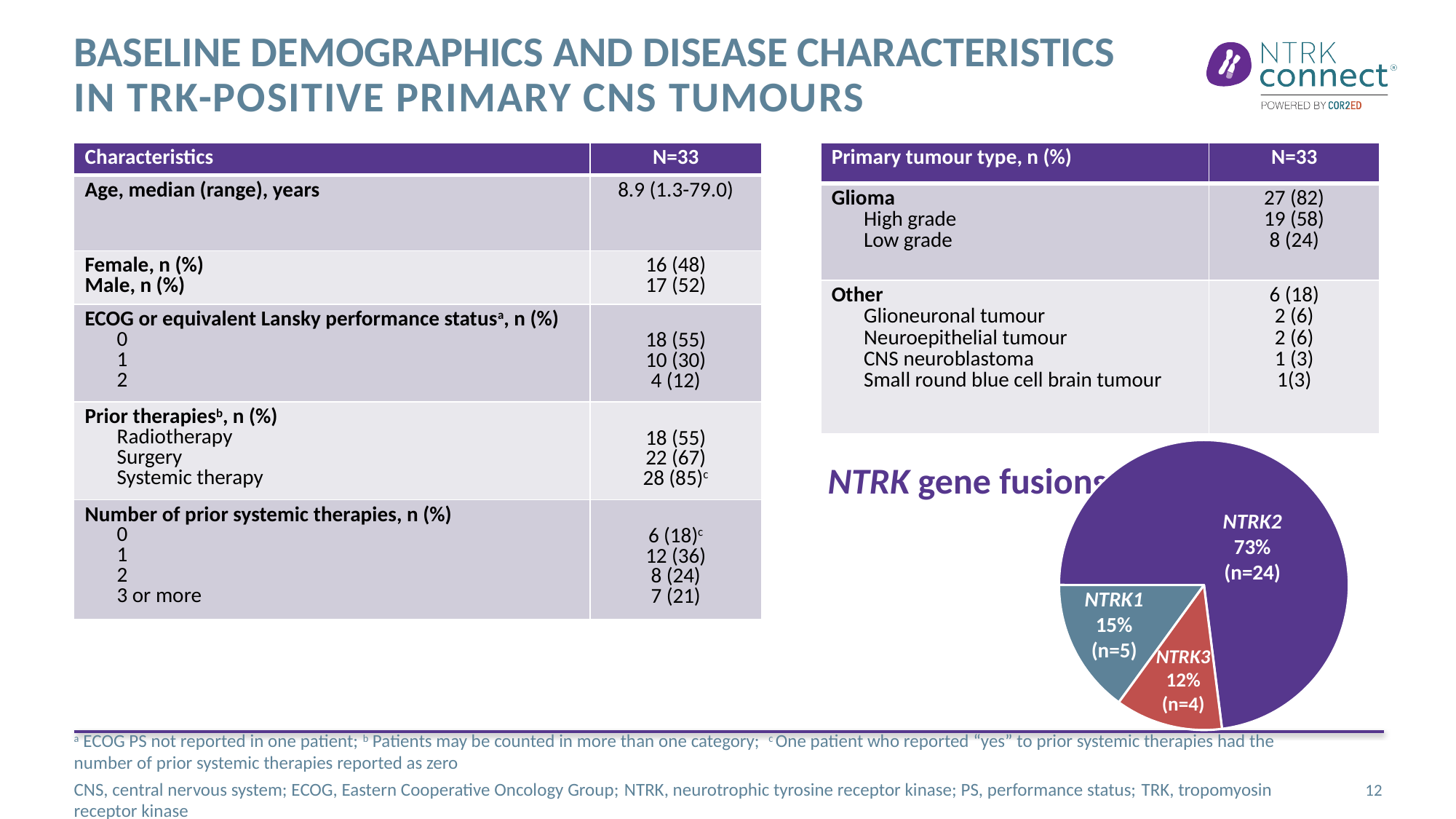
In the NTRK gene fusions pie chart, what is the difference in percentage points between the NTRK2 and NTRK1 slices? 58% In the NTRK gene fusions pie chart, how many patients (n) have NTRK1 fusions? n=5 In the NTRK gene fusions pie chart, what share of patients have NTRK3 fusions? 12% In the NTRK gene fusions pie chart, what share of patients have NTRK2 fusions? 73% What kind of chart is used to show the NTRK gene fusions? Pie chart In the NTRK gene fusions pie chart, which is larger: the NTRK1 slice or the NTRK3 slice? NTRK1 Which gene fusion accounts for the smallest slice of the NTRK gene fusions pie chart? NTRK3 In the NTRK gene fusions pie chart, how many patients (n) have NTRK2 fusions? n=24 In the NTRK gene fusions pie chart, what colour is the NTRK2 slice? Purple In the NTRK gene fusions pie chart, what share of patients have NTRK1 fusions? 15% How many slices does the NTRK gene fusions pie chart have? 3 Which gene fusion accounts for the largest slice of the NTRK gene fusions pie chart? NTRK2